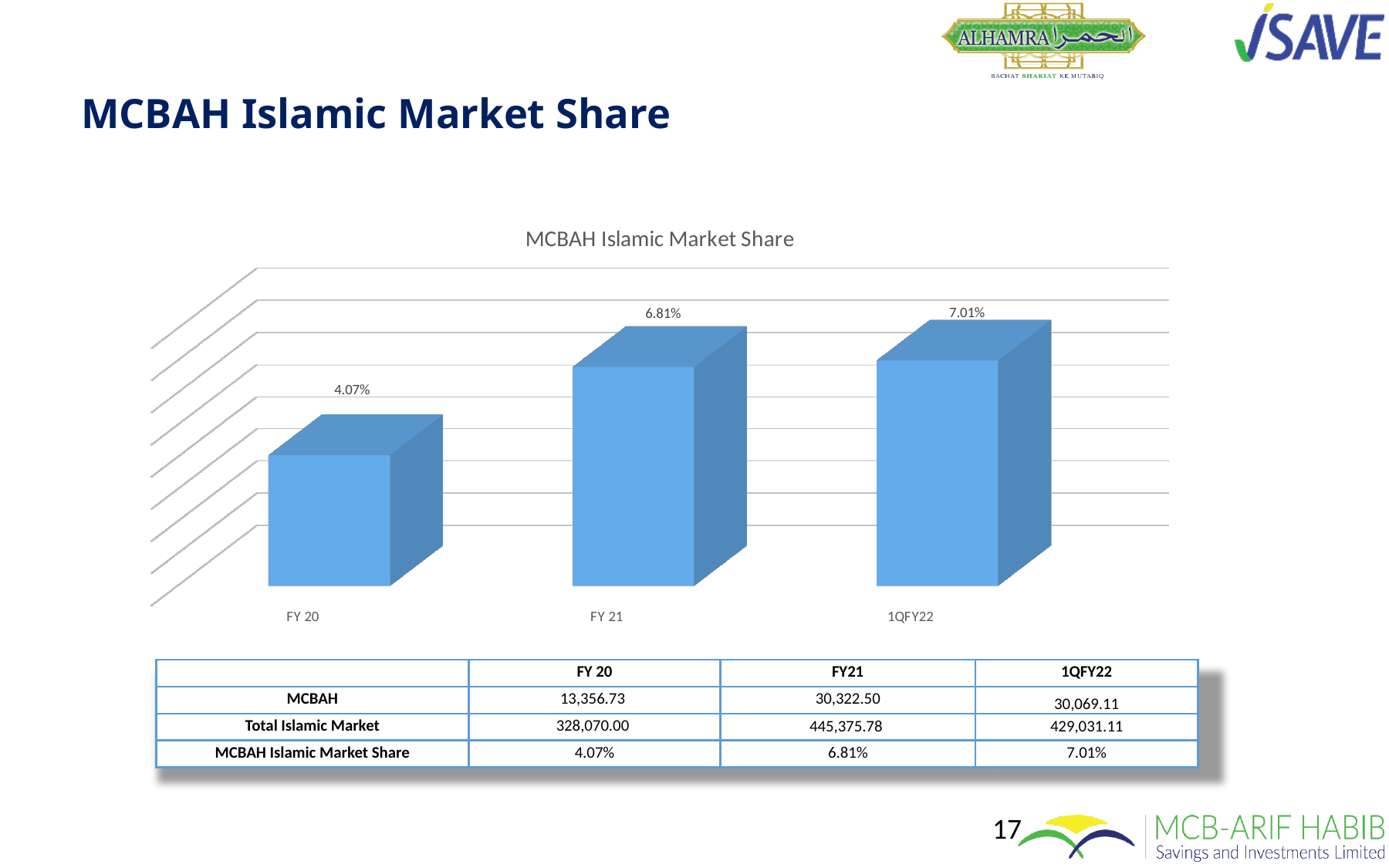
What is the title of the chart? MCBAH Islamic Market Share Which is larger, the market share for FY 20 or for FY 21? FY 21 What is the MCBAH Islamic Market Share for FY 21? 6.81% What is the MCBAH Islamic Market Share for 1QFY22? 7.01% How many periods are shown on the chart? 3 What kind of chart is shown on the slide? Bar chart Which period has the highest MCBAH Islamic Market Share? 1QFY22 What is the difference in market share between FY 21 and FY 20? 2.74% What is the MCBAH Islamic Market Share for FY 20? 4.07% What is the difference in market share between 1QFY22 and FY 21? 0.20% Do the market share values rise or fall from FY 20 to 1QFY22? Rise Which period has the lowest MCBAH Islamic Market Share? FY 20